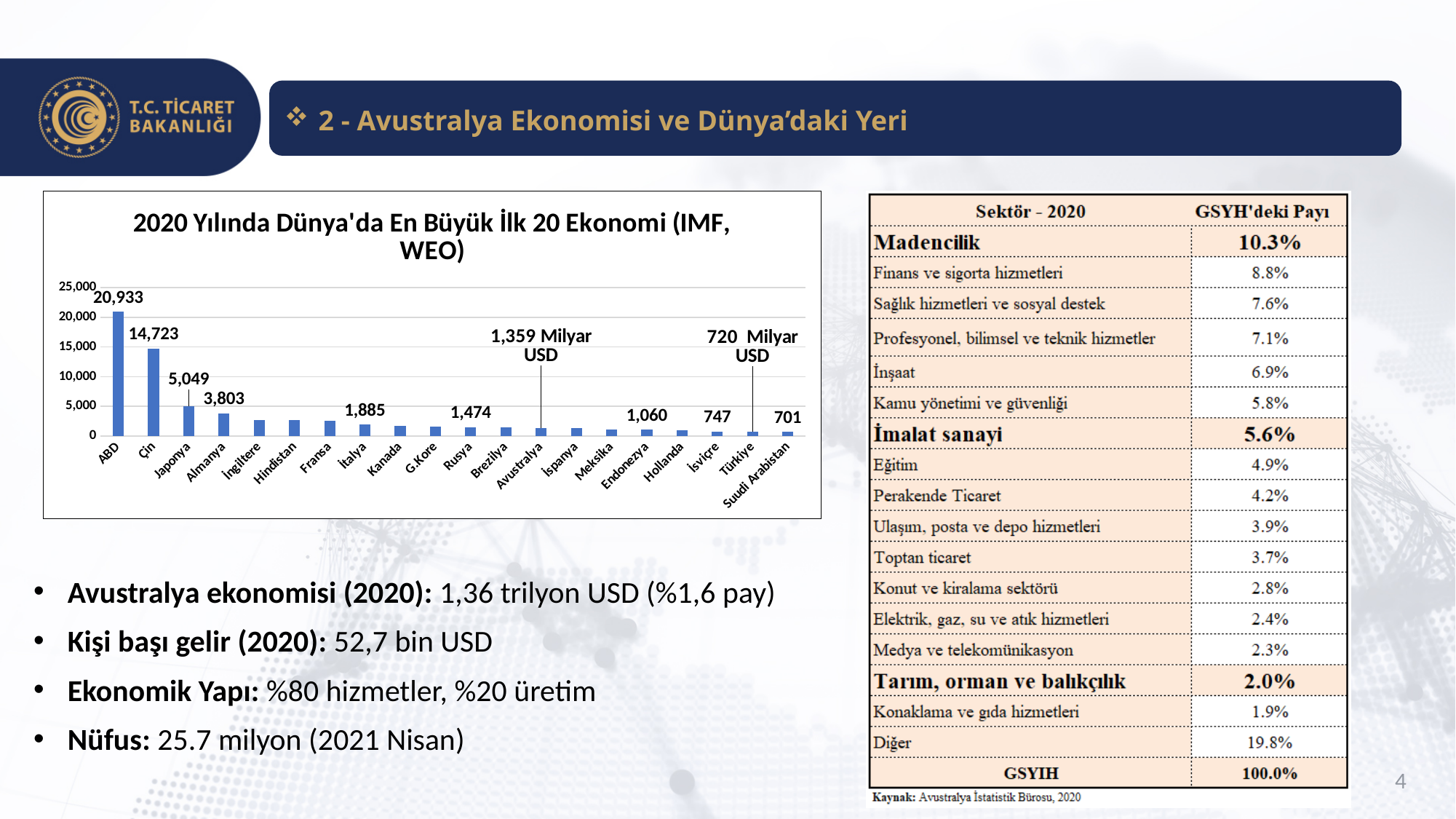
Which country has the highest value in the chart? ABD What value is labelled for Türkiye in the chart? 720 Milyar USD How many countries are shown in the chart? 20 What is the difference between the values for ABD and Çin? 6,210 Which country has the lowest value in the chart? Suudi Arabistan Do the values rise or fall from left to right along the x axis? fall What is the value for ABD in the chart? 20,933 What value is labelled for Avustralya in the chart? 1,359 Milyar USD What kind of chart is shown on the slide? bar chart What is the value for Çin in the chart? 14,723 Is the value for İngiltere greater or less than 5,000? less Which is larger, the value for Japonya or the value for Almanya? Japonya